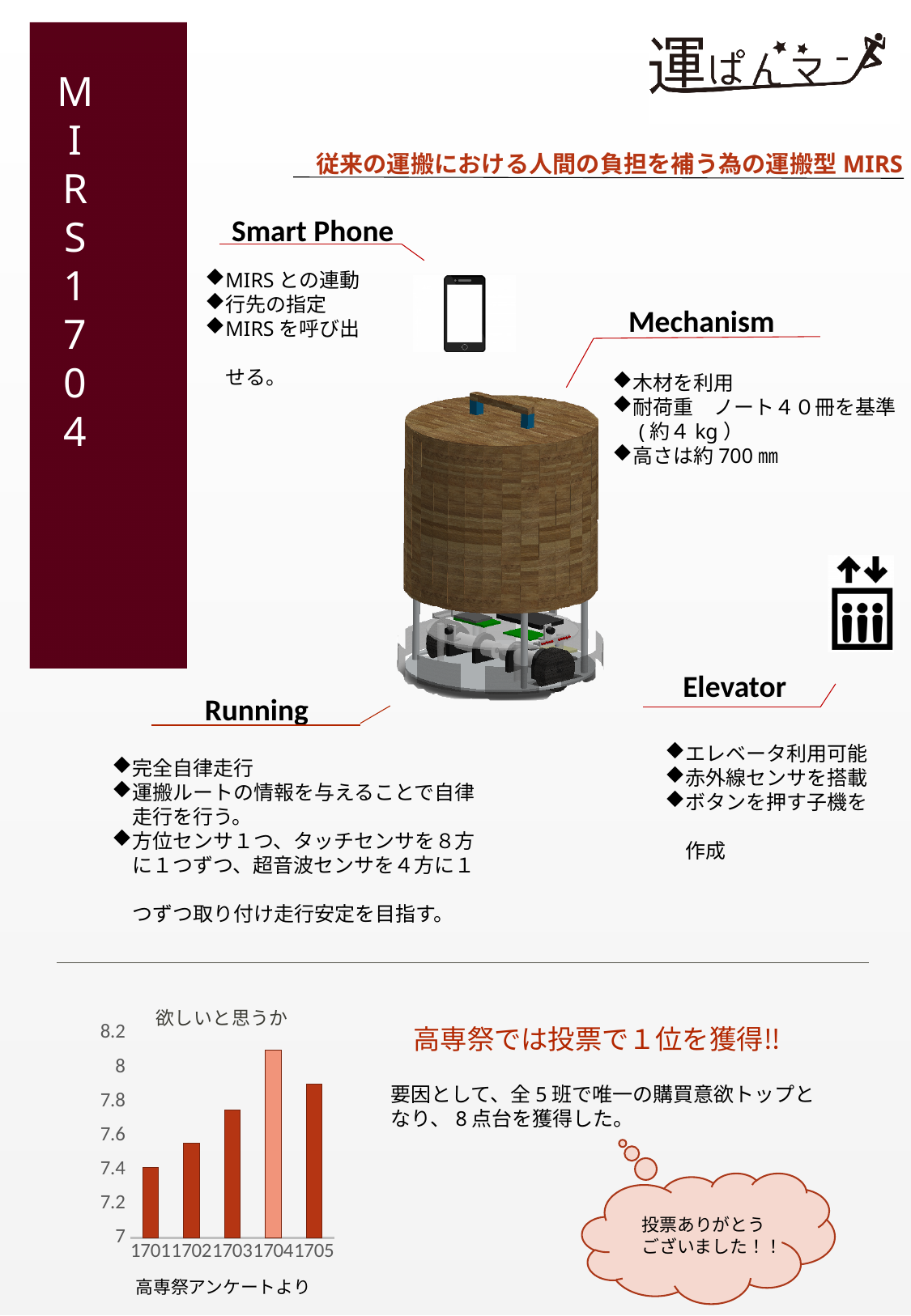
How many categories are shown on the x axis of the bar chart? 5 Is the value for 1704 greater or less than 8? greater Is the value for 1702 greater or less than 7.6? less What is the title of the bar chart? 欲しいと思うか Is the value for 1703 greater or less than 7.6? greater What kind of chart is shown at the bottom left of the slide? bar chart Which category has the highest bar in the chart? 1704 Which is larger, the value for 1705 or the value for 1703? 1705 Do the values rise or fall from 1701 to 1704? rise Which bar in the chart is drawn in a lighter colour than the others? 1704 Which category has the lowest bar in the chart? 1701